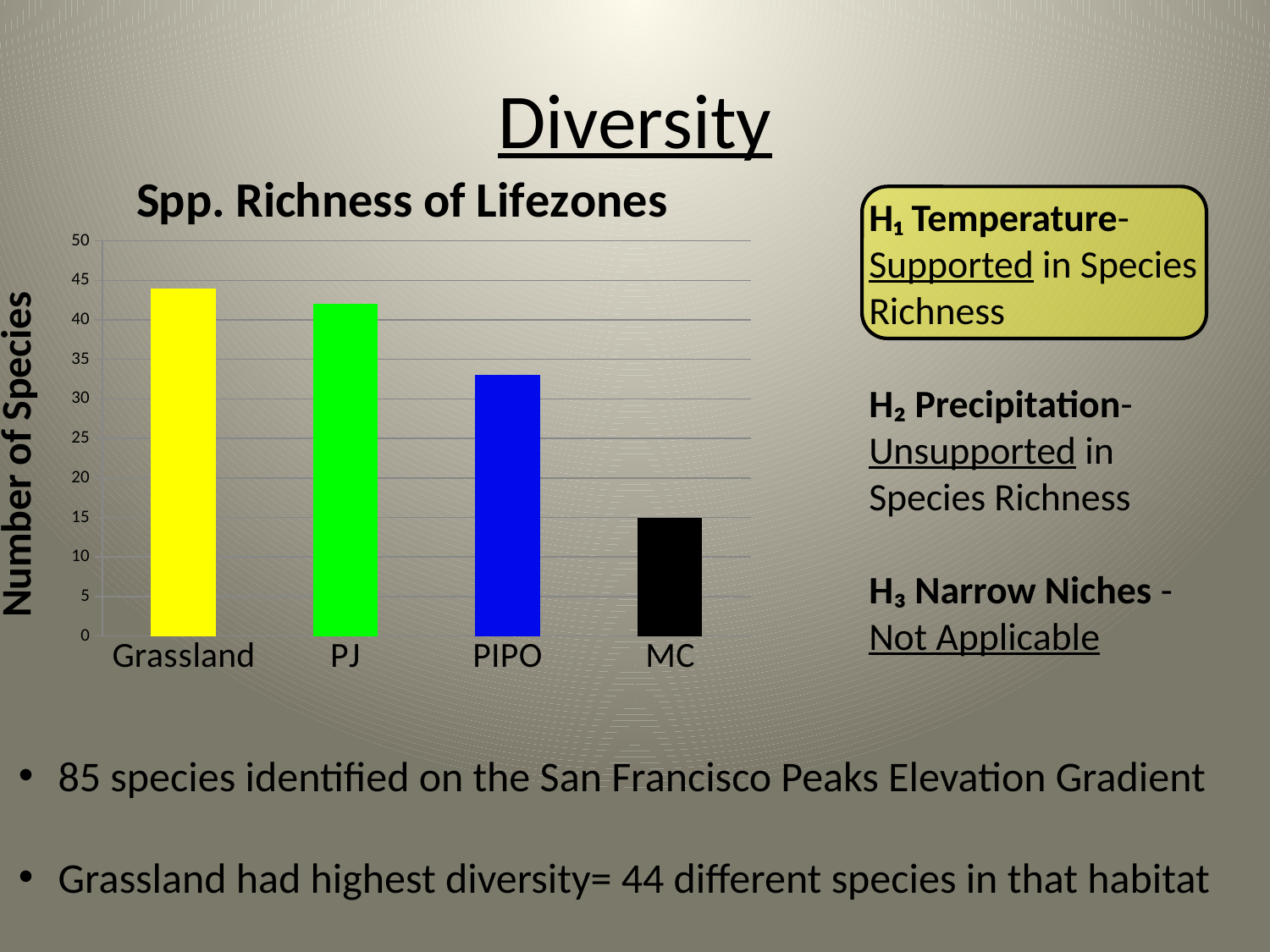
How many lifezone categories are plotted in the chart? 4 Is the value for PJ greater or less than 40? greater What is the title of the chart? Spp. Richness of Lifezones Which lifezone has the lowest number of species? MC What kind of chart is shown on the slide? bar chart Which has more species, PJ or PIPO? PJ How many species were identified in the Grassland lifezone? 44 Do the values rise or fall moving from Grassland to MC along the x axis? fall Is the value for PIPO greater or less than 30? greater Is the value for MC greater or less than 20? less What is the label on the vertical axis of the chart? Number of Species Which lifezone has the highest number of species? Grassland